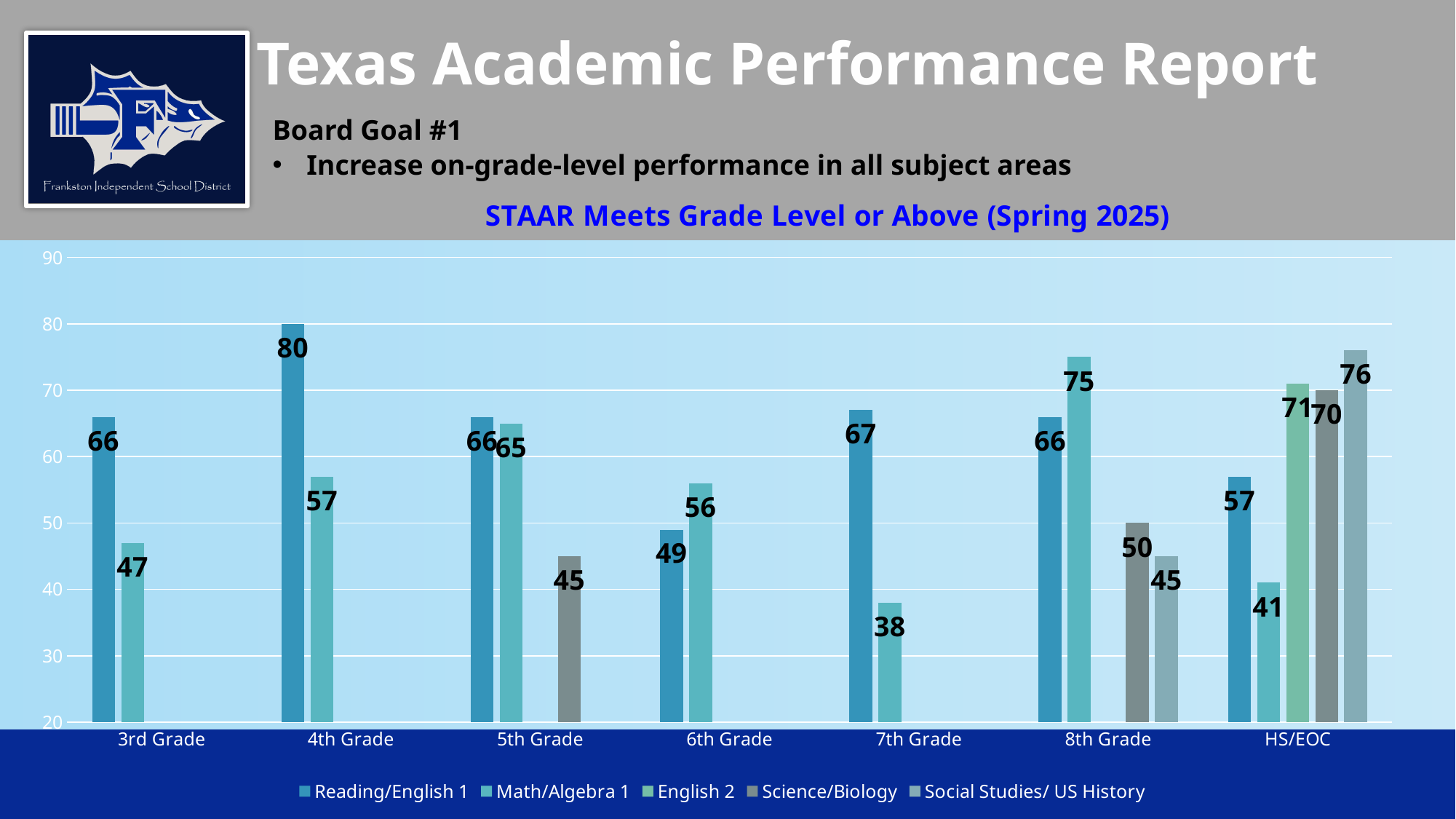
Which grade has the lowest Math/Algebra 1 value? 7th Grade What is the Social Studies/ US History value for HS/EOC? 76 For 8th Grade, which is larger: Reading/English 1 or Math/Algebra 1? Math/Algebra 1 How many grade-level categories are shown on the x axis? 7 What is the title of the chart? STAAR Meets Grade Level or Above (Spring 2025) What is the Math/Algebra 1 value for 7th Grade? 38 What is the Reading/English 1 value for 4th Grade? 80 What is the Science/Biology value for 8th Grade? 50 Which grade has the highest Reading/English 1 value? 4th Grade What is the difference between the Reading/English 1 and Math/Algebra 1 values for 3rd Grade? 19 How many series does the legend list? 5 What kind of chart is shown on the slide? Bar chart